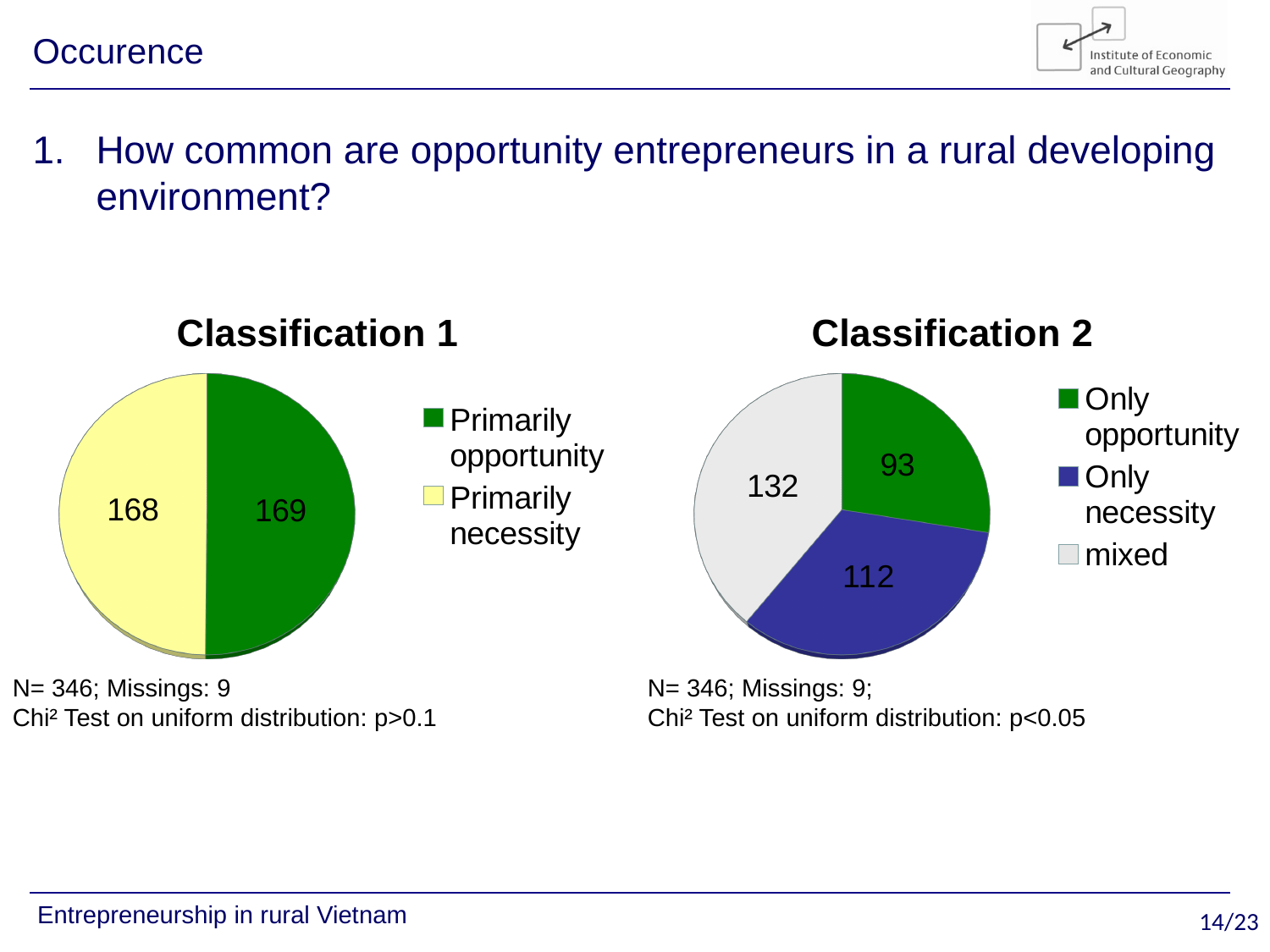
In the Classification 2 chart, which category has the largest value? mixed In the Classification 2 chart, what is the difference between the values for mixed and Only necessity? 20 What kind of chart is the Classification 1 chart? pie chart In the Classification 1 chart, what is the value for Primarily opportunity? 169 In the Classification 2 chart, which category has the smallest value? Only opportunity In the Classification 2 chart, what is the value for Only opportunity? 93 In the Classification 2 chart, what colour is the Only necessity slice? blue In the Classification 1 chart, what is the value for Primarily necessity? 168 How many categories does the Classification 2 chart show? 3 In the Classification 1 chart, what is the difference between the values for Primarily opportunity and Primarily necessity? 1 In the Classification 2 chart, which is larger, Only necessity or Only opportunity? Only necessity In the Classification 2 chart, what is the value for mixed? 132